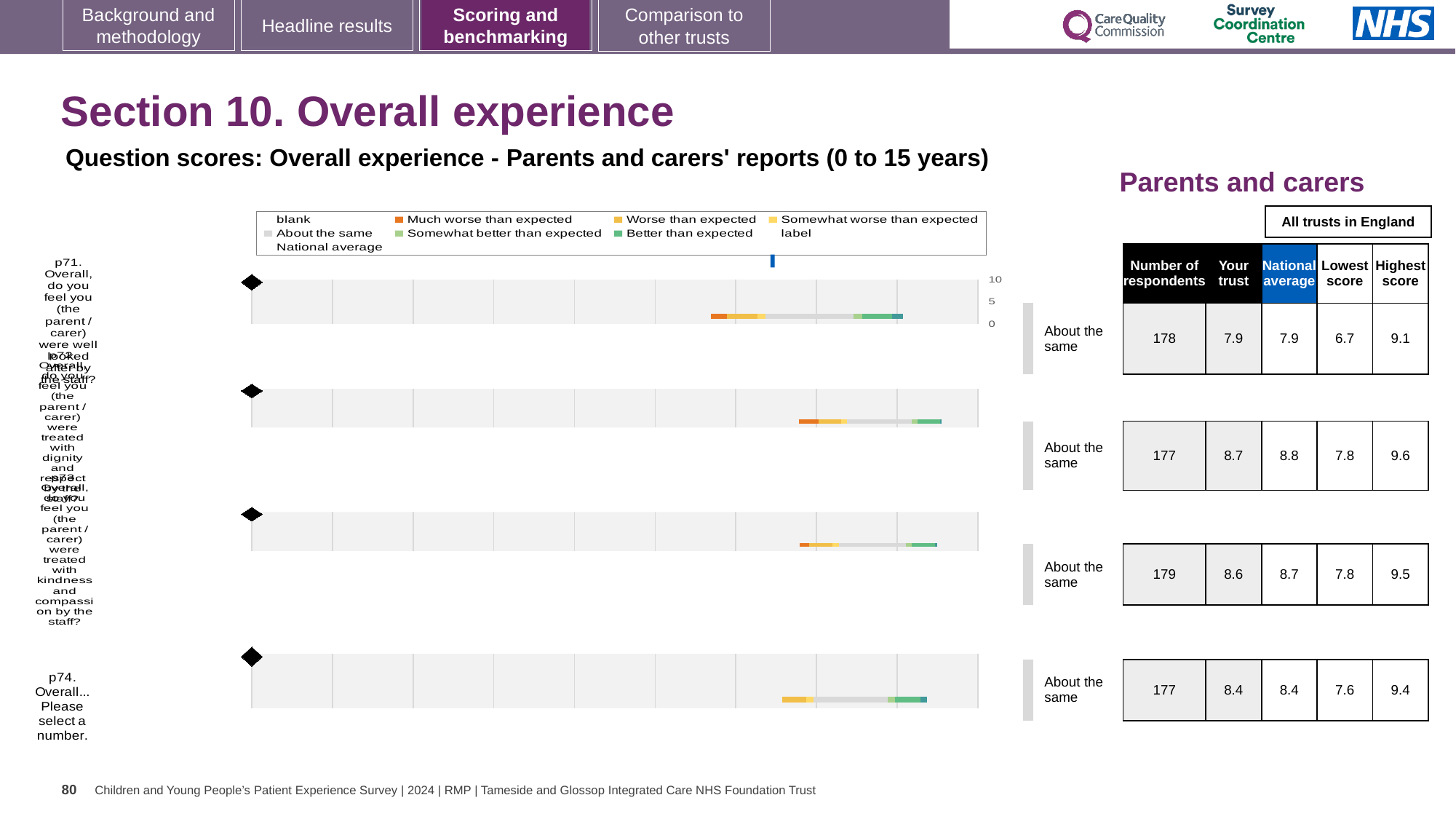
What is the highest score across all trusts in England shown for question p74? 9.4 What is the title of the chart on this slide? Question scores: Overall experience - Parents and carers' reports (0 to 15 years) Which of the four questions has the lowest 'Your trust' score? p71 (7.9) What is the national average shown for question p74 (Overall... Please select a number)? 8.4 Is the 'Your trust' score for p73 larger or smaller than the national average for p73? smaller How many question rows (bars) are plotted in the chart? 4 What is the difference between the highest score and the lowest score shown for question p71? 2.4 What benchmark category is shown for question p74? About the same How many respondents are shown for question p71? 178 What kind of chart is used to show the question scores on this slide? bar chart What is the 'Your trust' score shown for question p71 (Overall, do you feel you were well looked after by the staff)? 7.9 Which of the four questions has the highest 'Your trust' score? p72 (8.7)